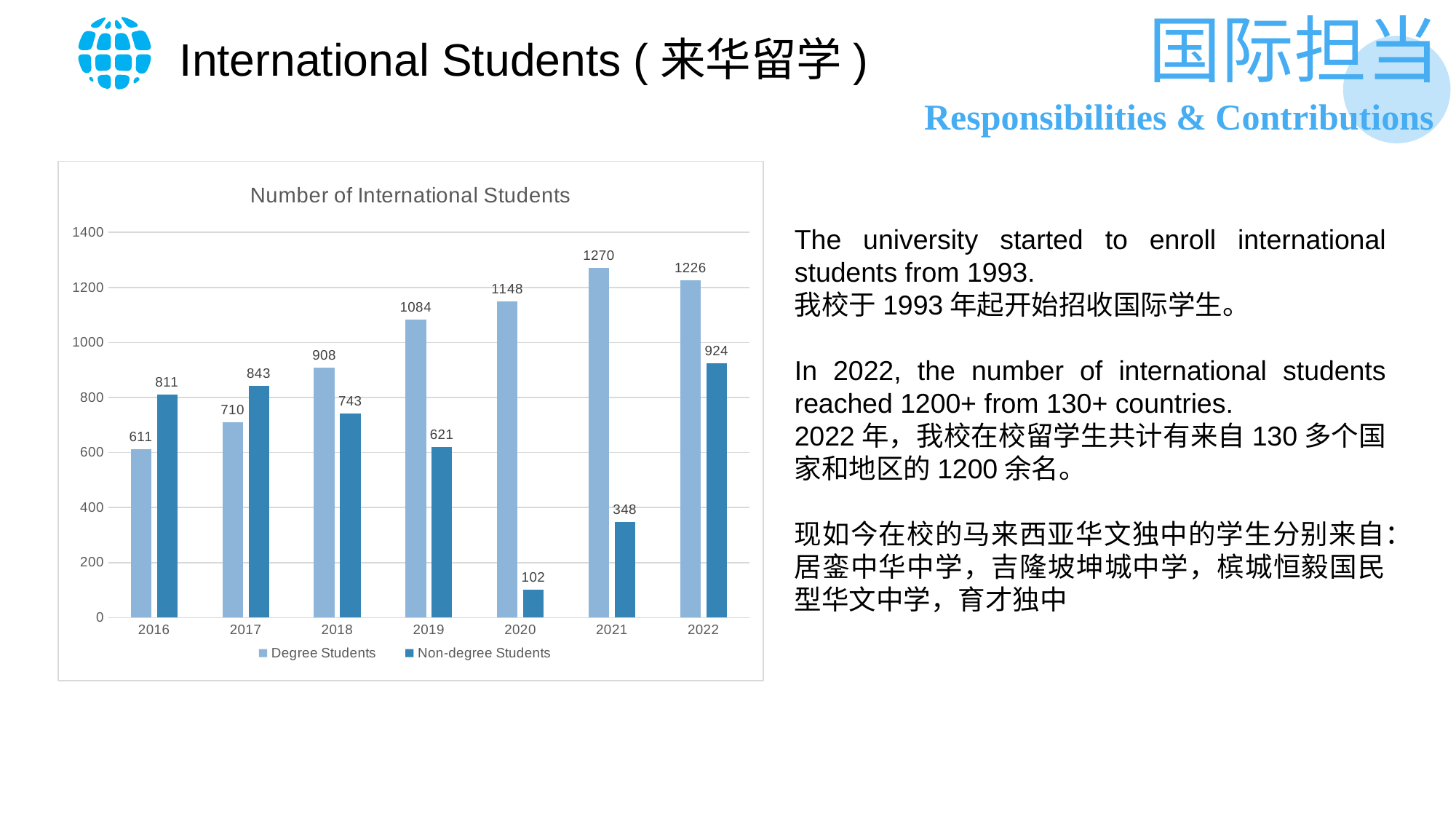
What is the difference between Degree Students and Non-degree Students in 2022? 302 Which year has the lowest number of Non-degree Students? 2020 How many years are shown on the x axis? 7 How many series does the legend list? 2 Do the Degree Students values rise or fall from 2016 to 2021? rise What is the number of Non-degree Students in 2020? 102 What kind of chart is shown on the slide? bar chart What is the number of Degree Students in 2019? 1084 In 2016, which is larger: Degree Students or Non-degree Students? Non-degree Students Which year has the highest number of Degree Students? 2021 Is the number of Degree Students in 2018 greater or less than 1000? less What is the title of the chart? Number of International Students